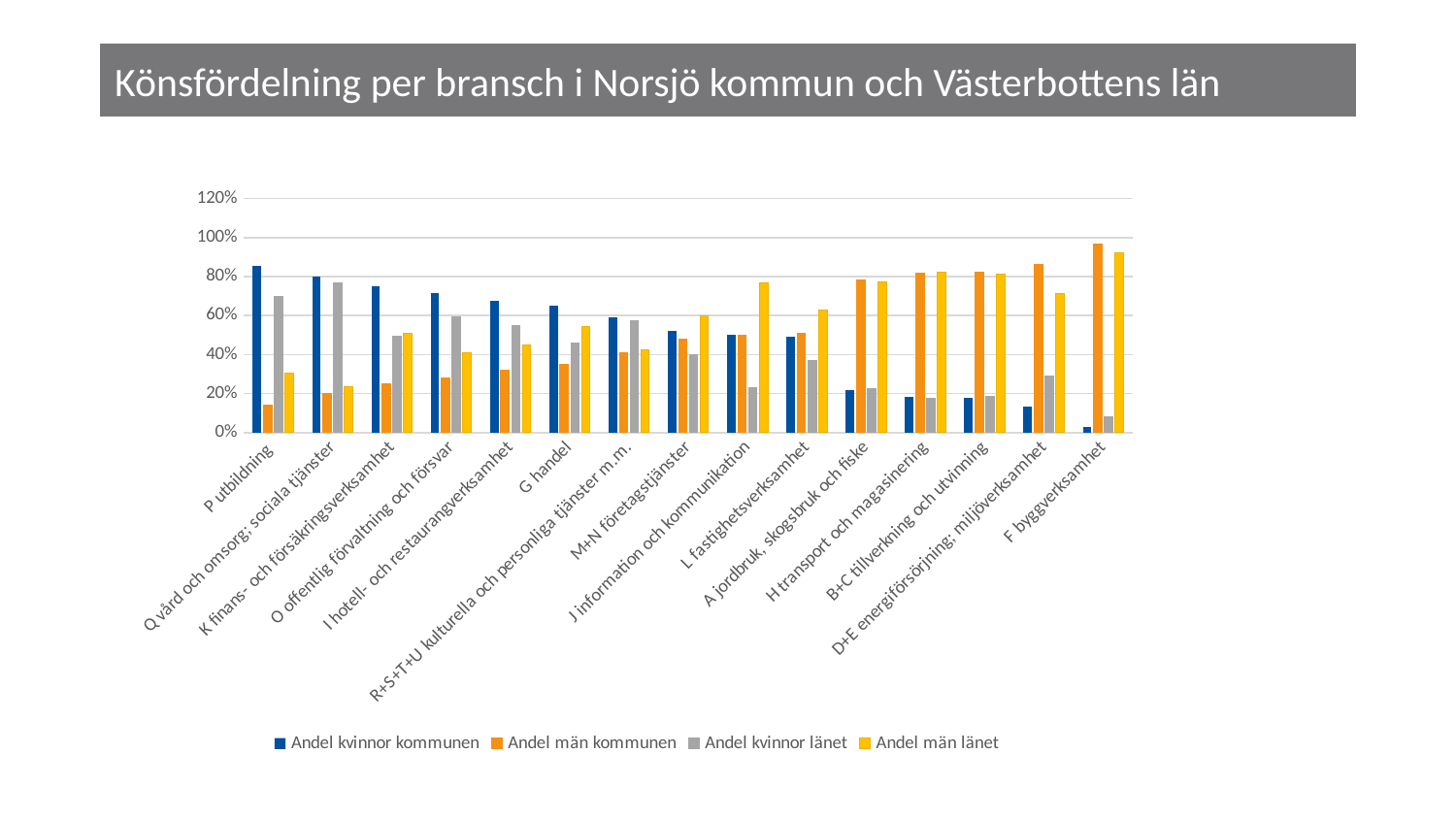
For P utbildning, which is larger: Andel kvinnor kommunen or Andel män kommunen? Andel kvinnor kommunen Is the value for Andel kvinnor kommunen in P utbildning greater or less than 80%? greater Which category has the lowest value for Andel kvinnor kommunen? F byggverksamhet Which category has the highest value for Andel män kommunen? F byggverksamhet Which category has the lowest value for Andel män kommunen? P utbildning Is the value for Andel kvinnor länet in J information och kommunikation greater or less than 40%? less Do the values for Andel kvinnor kommunen generally rise or fall from left to right along the x axis? fall Is the value for Andel män kommunen in F byggverksamhet greater or less than 80%? greater How many series does the legend list? 4 How many industry categories are shown on the x axis? 15 What kind of chart is shown on the slide? bar chart Which category has the highest value for Andel kvinnor kommunen? P utbildning